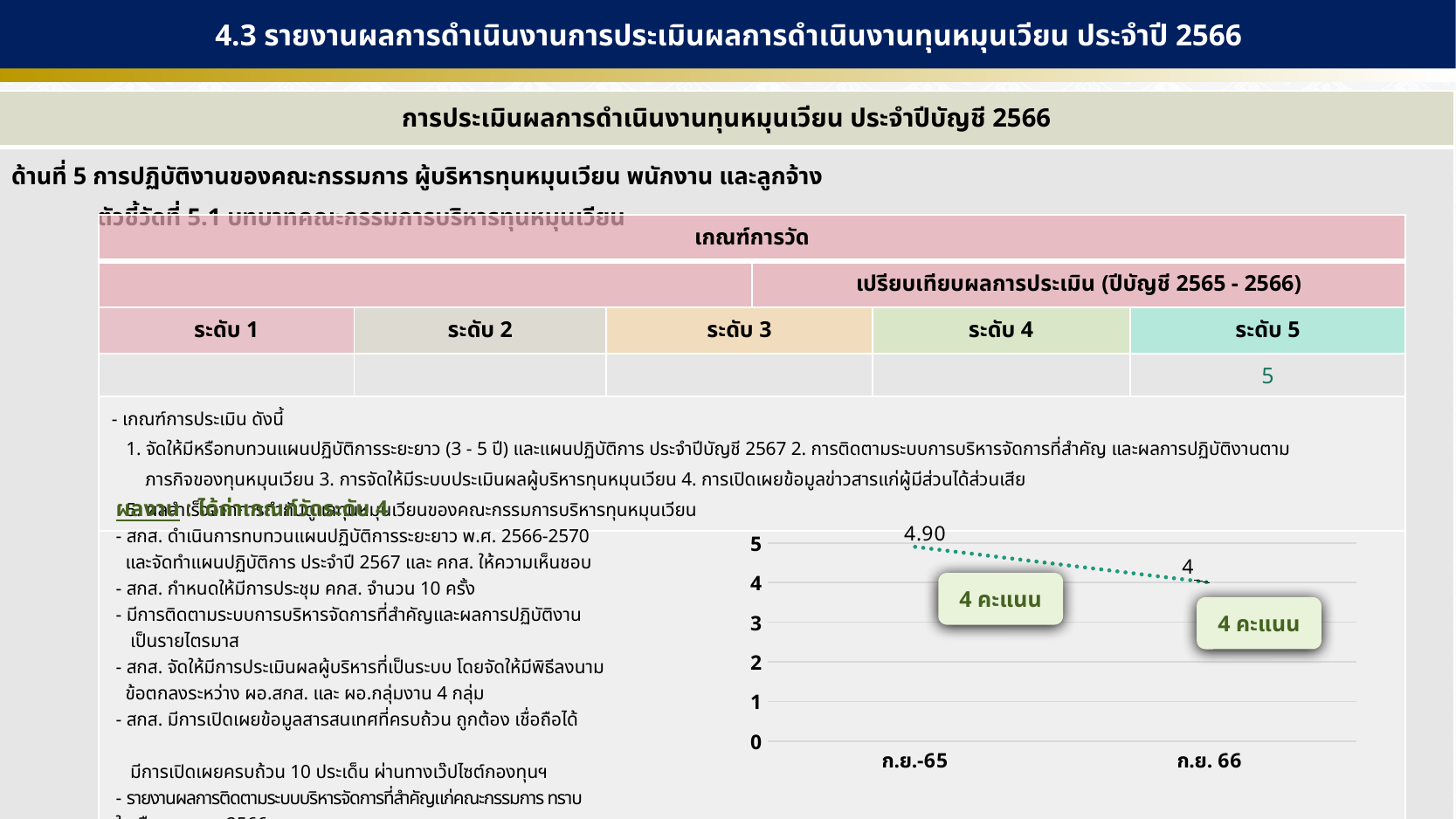
What style of line connects the two points on the chart? dotted line Which category on the chart has the lowest value? ก.ย. 66 Which point on the chart has the higher value, ก.ย.-65 or ก.ย. 66? ก.ย.-65 What is the maximum value shown on the chart's vertical axis? 5 Do the values on the chart rise or fall from ก.ย.-65 to ก.ย. 66? fall Is the value for ก.ย.-65 greater or less than 4? greater What is the value plotted for ก.ย.-65 in the chart? 4.90 What kind of chart is shown on the slide? line chart How many data points are plotted on the chart? 2 What is the difference between the value for ก.ย.-65 and the value for ก.ย. 66? 0.90 What is the value plotted for ก.ย. 66 in the chart? 4 Which category on the chart has the highest value? ก.ย.-65